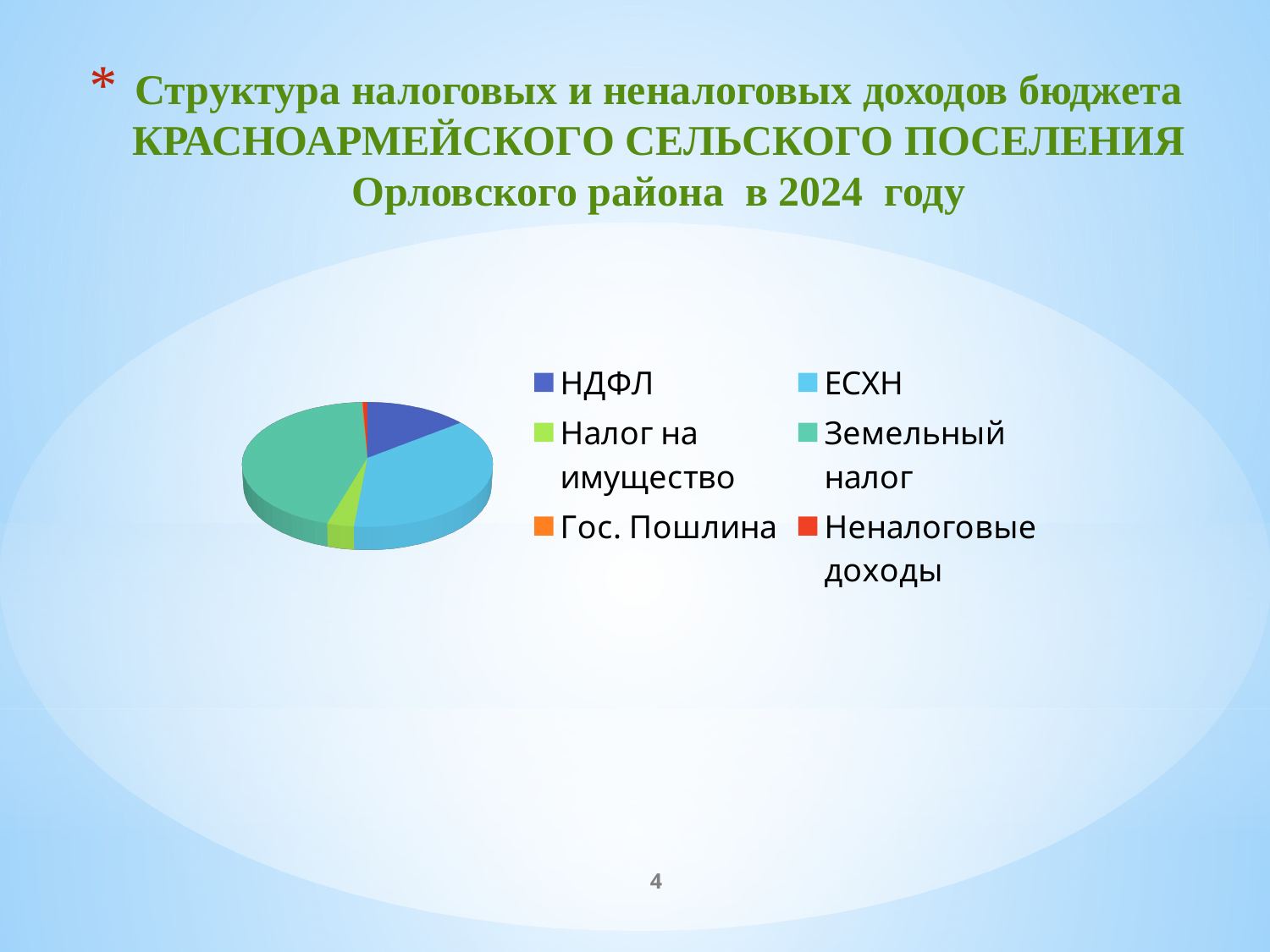
Which year does the slide title say the budget income structure refers to? 2024 Which is larger in the pie chart, the slice for Земельный налог or the slice for Налог на имущество? Земельный налог How many categories does the legend of the pie chart list? 6 Which is larger in the pie chart, the slice for НДФЛ or the slice for Налог на имущество? НДФЛ Which is larger in the pie chart, the slice for ЕСХН or the slice for НДФЛ? ЕСХН Which legend entry of the pie chart is shown in red? Неналоговые доходы What kind of chart is shown on the slide? pie chart